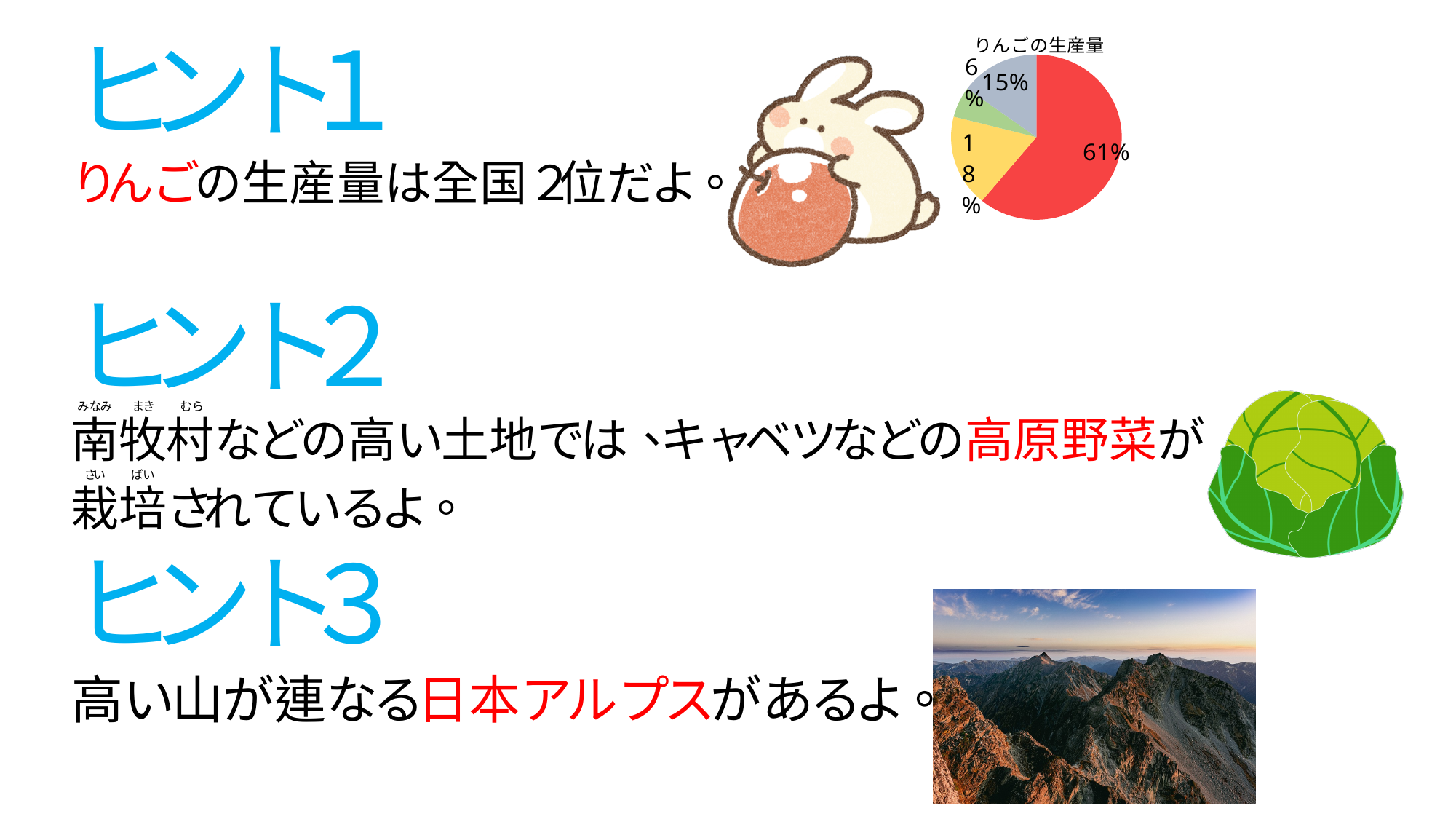
What colour is the largest slice of the pie chart? red How many slices does the pie chart have? 4 What do the four slice percentages in the pie chart add up to? 100% By how many percentage points is the largest slice (61%) bigger than the 18% slice? 43 percentage points What is the title of the pie chart? りんごの生産量 What is the percentage of the smallest slice in the pie chart? 6% What percentage is shown for the grey slice of the pie chart? 15% What percentage is shown for the yellow slice of the pie chart? 18% What percentage is shown for the red slice of the pie chart? 61% Which slice is larger, the yellow slice or the grey slice? the yellow slice (18%) What is the percentage of the largest slice in the pie chart? 61% What kind of chart is shown on the slide? pie chart